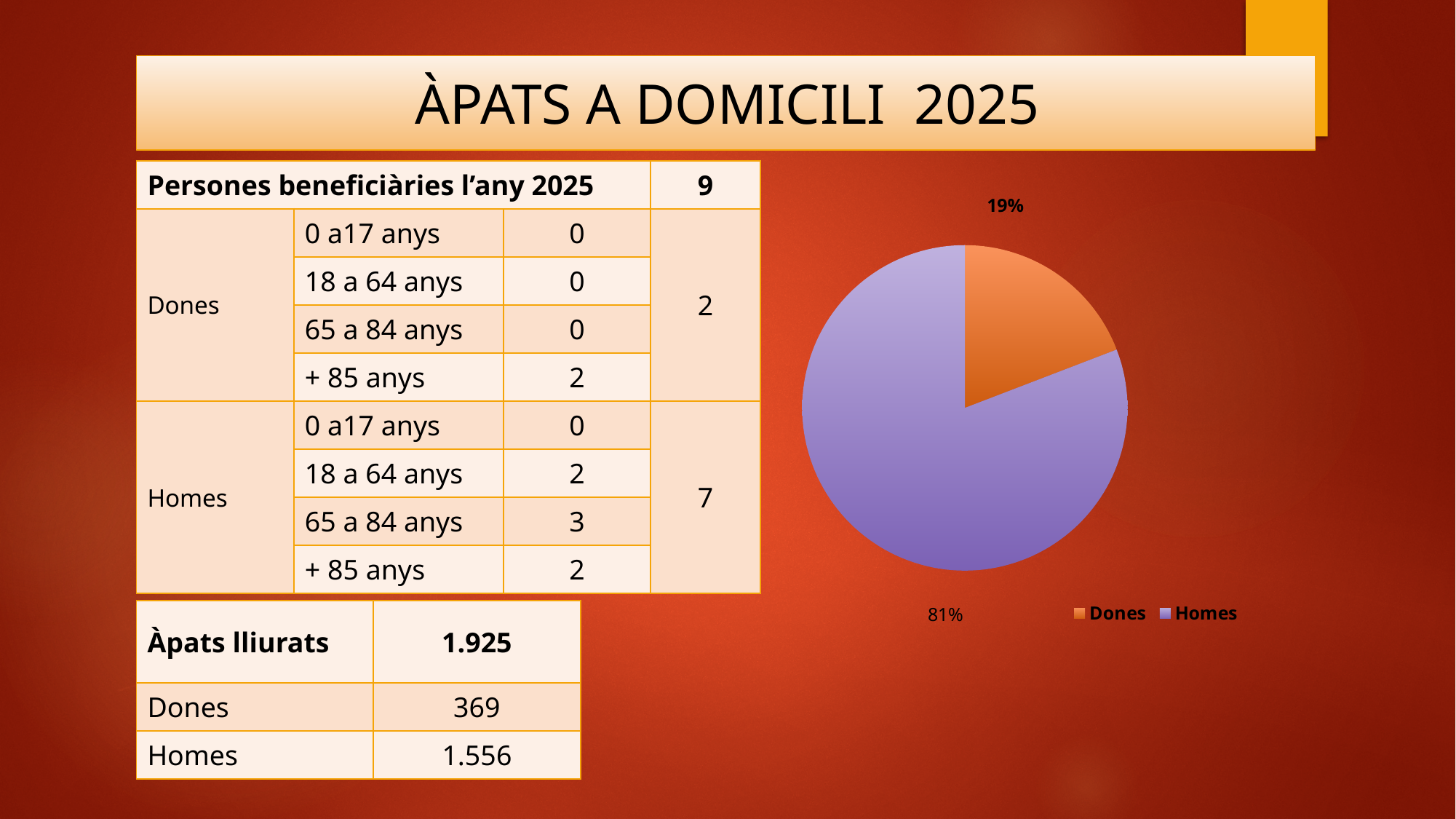
What colour is the Homes slice in the pie chart? Purple What colour is the Dones slice in the pie chart? Orange Which is larger in the pie chart, Dones or Homes? Homes How many entries does the pie chart legend list? 2 What share of the pie chart does Homes represent? 81% Which slice of the pie chart is the largest? Homes What kind of chart is shown on the slide? Pie chart What share of the pie chart does Dones represent? 19% How many slices does the pie chart have? 2 What is the difference in percentage points between the Homes and Dones slices of the pie chart? 62 Which slice of the pie chart is the smallest? Dones